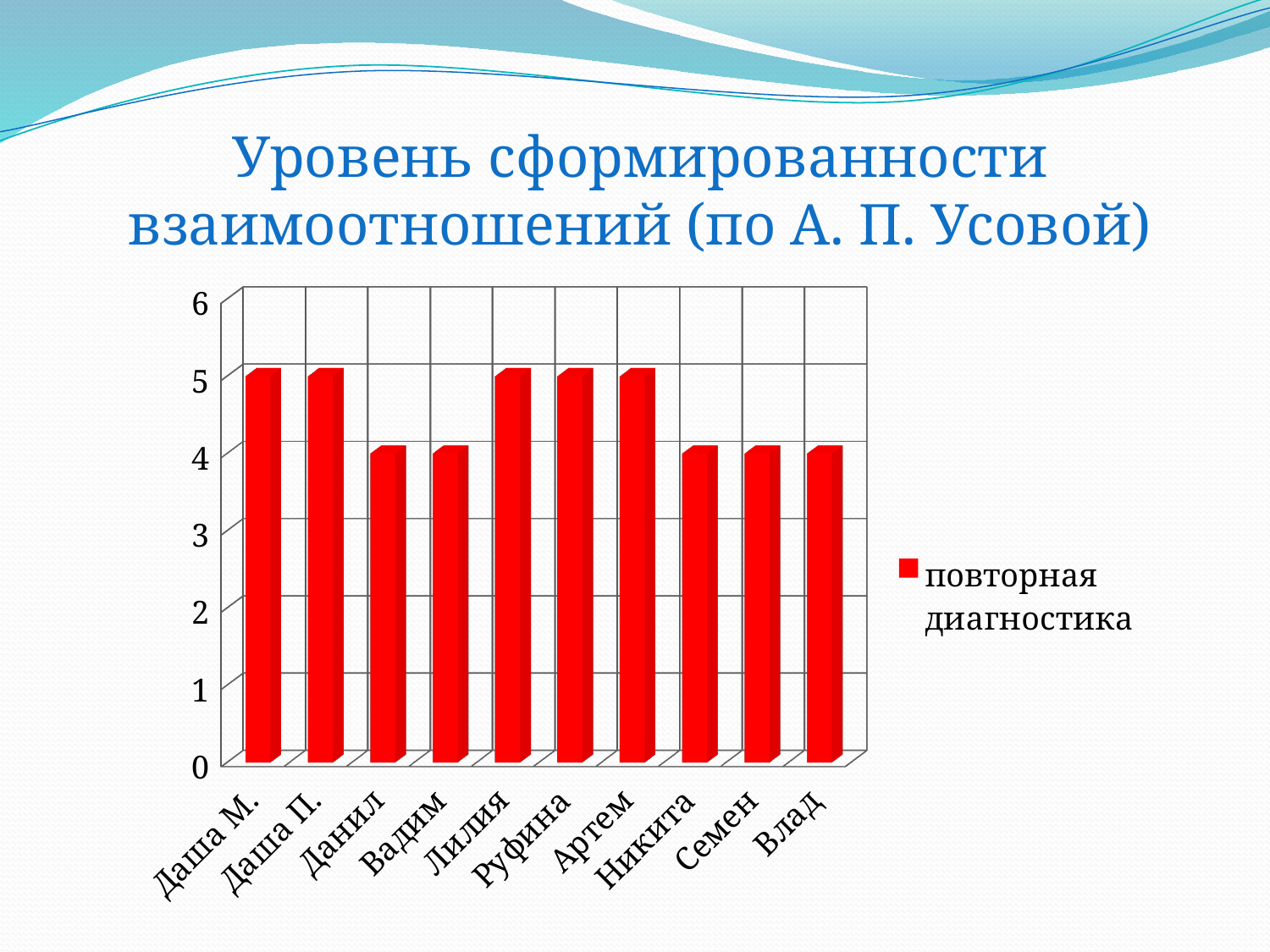
What is the difference between the value for Лилия and the value for Вадим in the chart? 1 What is the value for Руфина in the chart? 5 How many categories (children) are shown on the x axis of the chart? 10 What is the value for Данил in the chart? 4 How many series does the chart's legend list? 1 What is the name of the series shown in the chart's legend? повторная диагностика What is the title of the chart on the slide? Уровень сформированности взаимоотношений (по А. П. Усовой) Is the value for Семен greater or less than 5? less Which is larger in the chart, the value for Артем or the value for Никита? Артем What is the value for Даша М. in the chart? 5 What kind of chart is shown on the slide? bar chart What is the value for Влад in the chart? 4